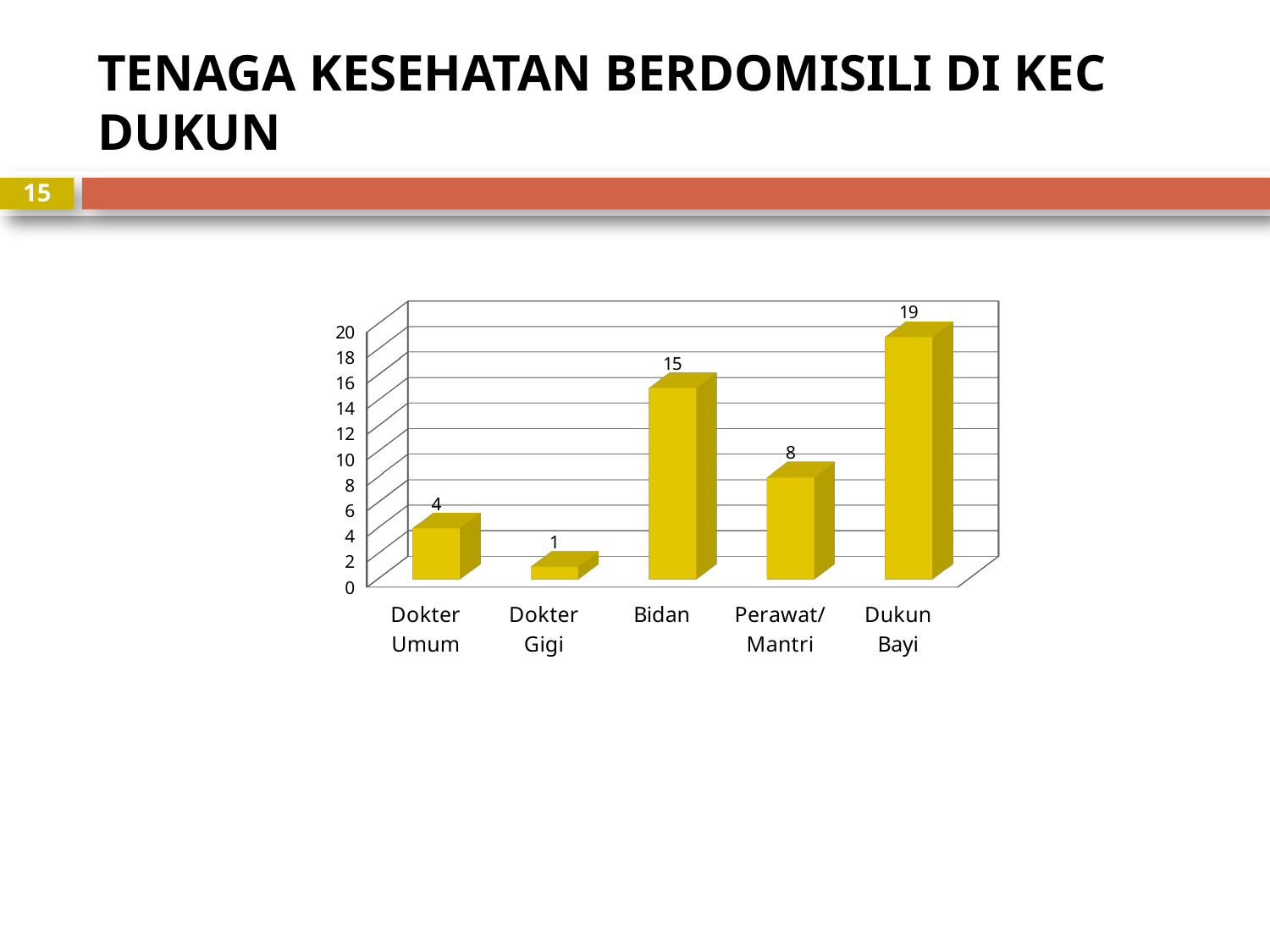
What is the value for Dokter Umum? 4 Which category has the highest value? Dukun Bayi What is the value for Dukun Bayi? 19 Which is larger, the value for Bidan or the value for Perawat/Mantri? Bidan What is the difference between the values for Dukun Bayi and Bidan? 4 What is the title of the slide containing the chart? TENAGA KESEHATAN BERDOMISILI DI KEC DUKUN What kind of chart is shown on the slide? Bar chart Which category has the lowest value? Dokter Gigi How many categories are shown on the x axis? 5 What is the value for Bidan? 15 What is the value for Perawat/Mantri? 8 What is the value for Dokter Gigi? 1